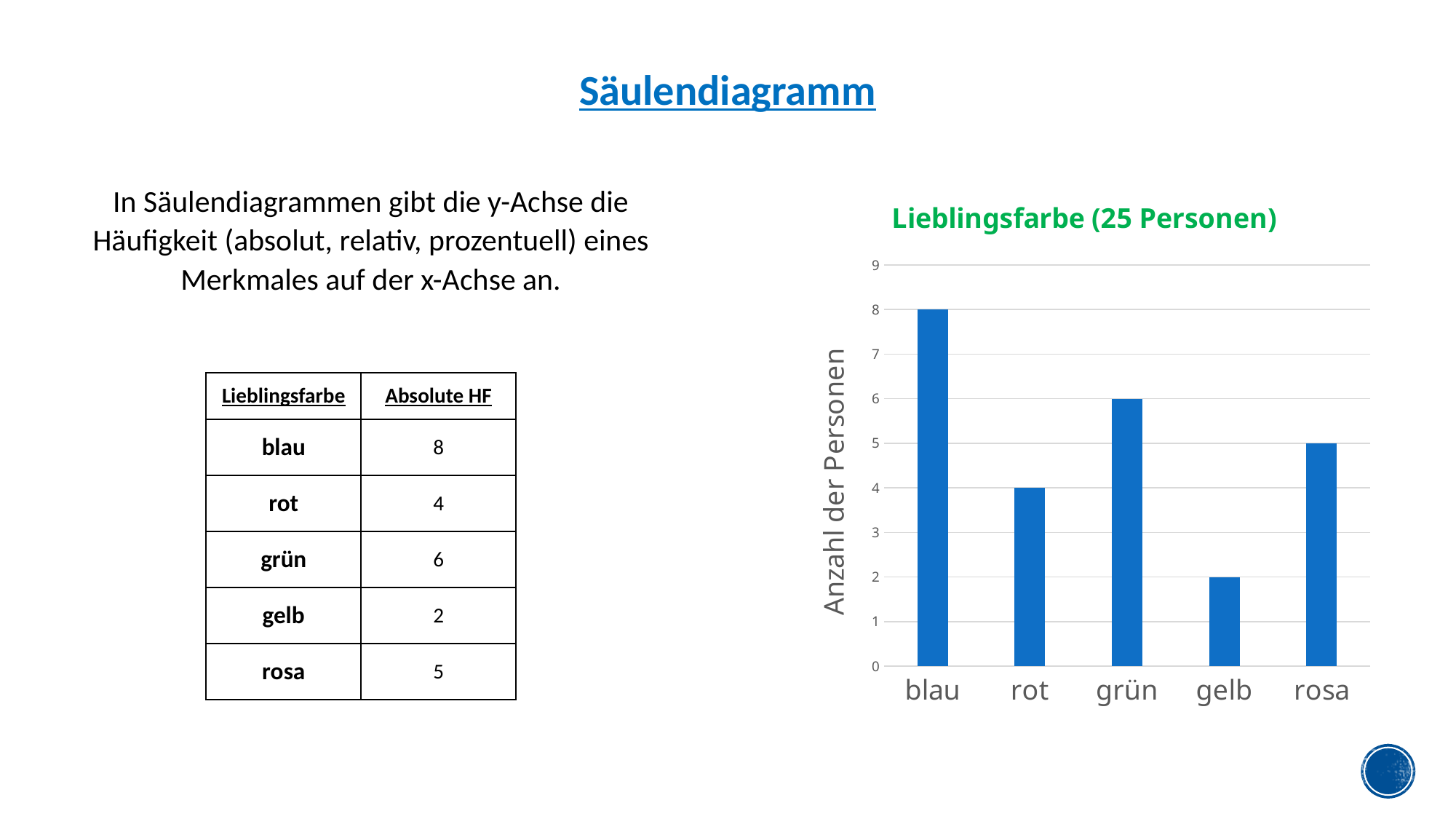
Which category has the highest bar in the chart? blau Which is larger, the value for rot or the value for rosa? rosa What is the difference between the values for grün and rosa? 1 What is the value for blau in the chart? 8 Which category has the lowest bar in the chart? gelb What is the title of the chart? Lieblingsfarbe (25 Personen) What is the value for gelb in the chart? 2 What is the difference between the values for blau and rot? 4 What kind of chart is shown on the slide? bar chart How many categories are shown on the x axis of the chart? 5 Is the value for grün greater or less than 5? greater What is the value for rosa in the chart? 5